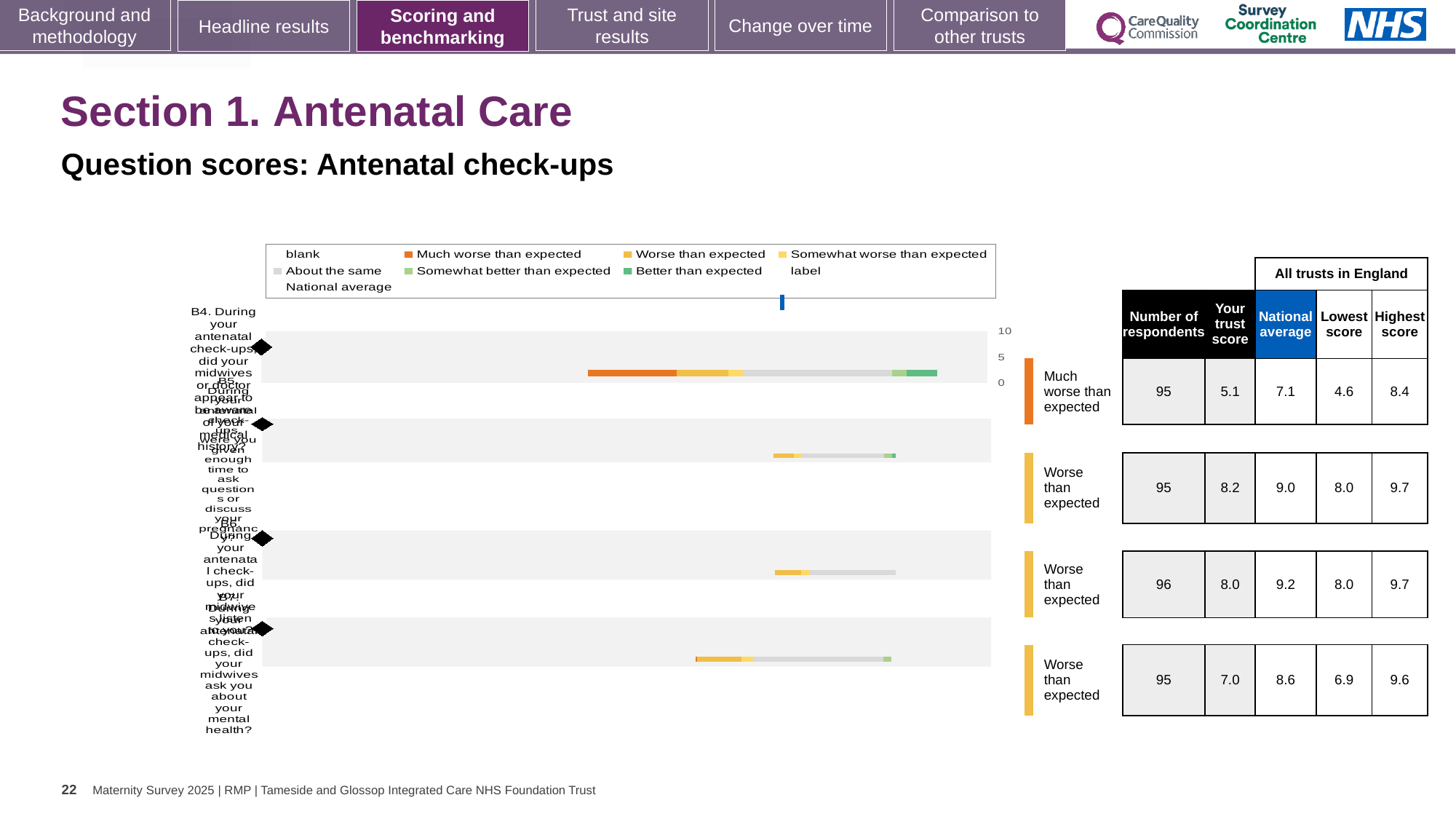
Which row has the lowest 'Your trust score'? the first row, B4 (5.1) Which row has the highest 'Your trust score'? the second row (8.2) What is the number of respondents for the third row? 96 For the fourth (bottom) row, which is larger: the trust score or the national average? the national average (8.6) What is the highest score among all trusts in England for the fourth (bottom) row? 9.6 What rating label is shown next to the first (top) row? Much worse than expected How many question rows (bars) are plotted in the chart? 4 What is the 'Your trust score' for the first (top) row, question B4? 5.1 What is the subtitle of the chart section on the slide? Question scores: Antenatal check-ups What kind of chart is shown on the slide? bar chart What is the national average for the first (top) row, question B4? 7.1 For the first row (B4), what is the difference between the national average and the trust score? 2.0